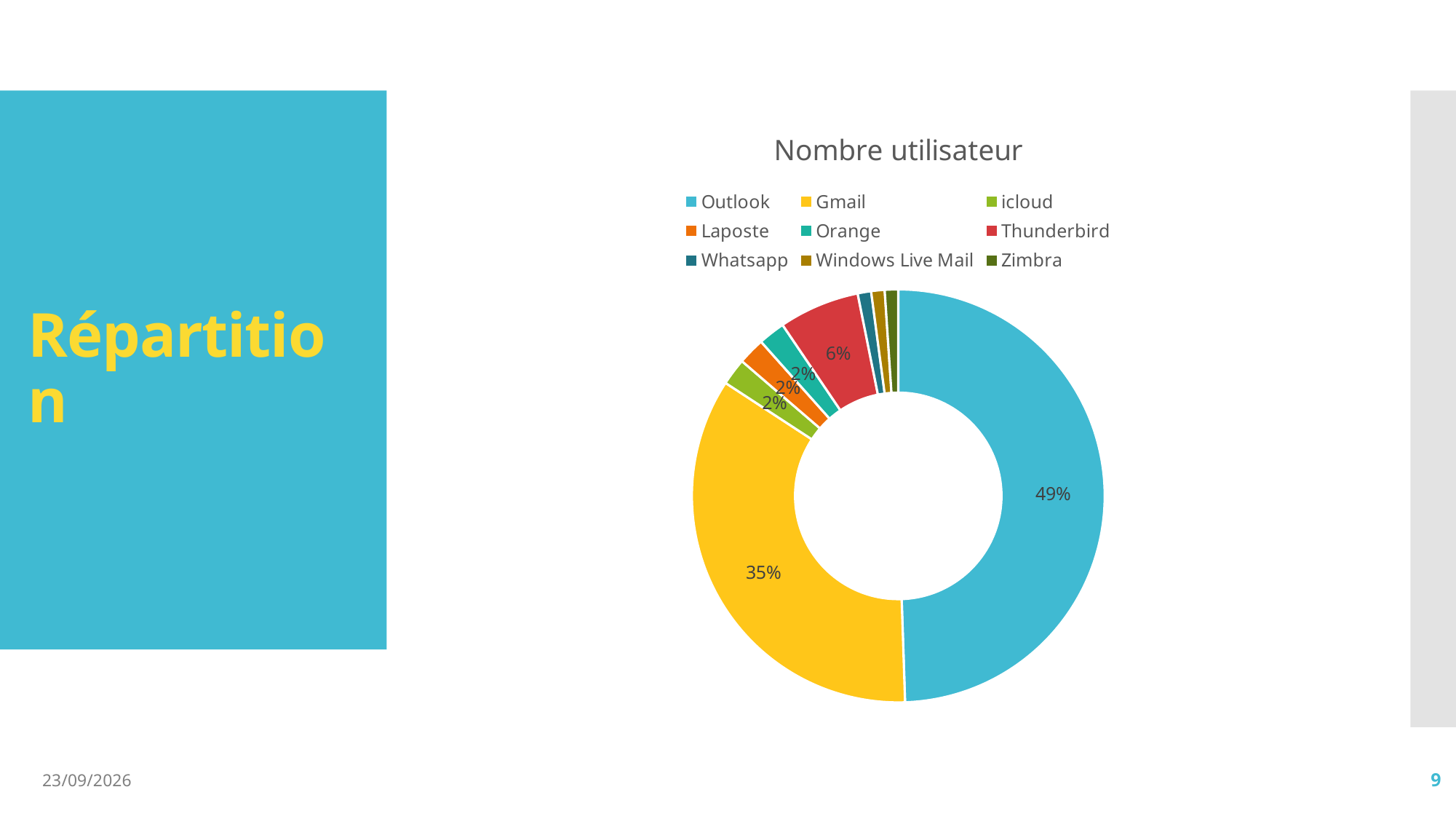
By how many percentage points does Outlook's share exceed Gmail's share in the "Nombre utilisateur" chart? 14 percentage points What percentage is shown for icloud in the "Nombre utilisateur" chart? 2% What percentage is labelled for Thunderbird in the "Nombre utilisateur" chart? 6% What is the title of the chart on the slide? Nombre utilisateur Which has the larger share in the "Nombre utilisateur" chart, Gmail or Thunderbird? Gmail What share of the pie does Outlook hold in the "Nombre utilisateur" chart? 49% How many categories does the legend of the "Nombre utilisateur" chart list? 9 What is the value shown for Gmail in the "Nombre utilisateur" chart? 35% What kind of chart is shown on the slide? Doughnut (pie) chart Which category has the largest slice in the "Nombre utilisateur" chart? Outlook What is the combined share of Outlook and Gmail in the "Nombre utilisateur" chart? 84% Which category is shown in yellow in the "Nombre utilisateur" chart? Gmail